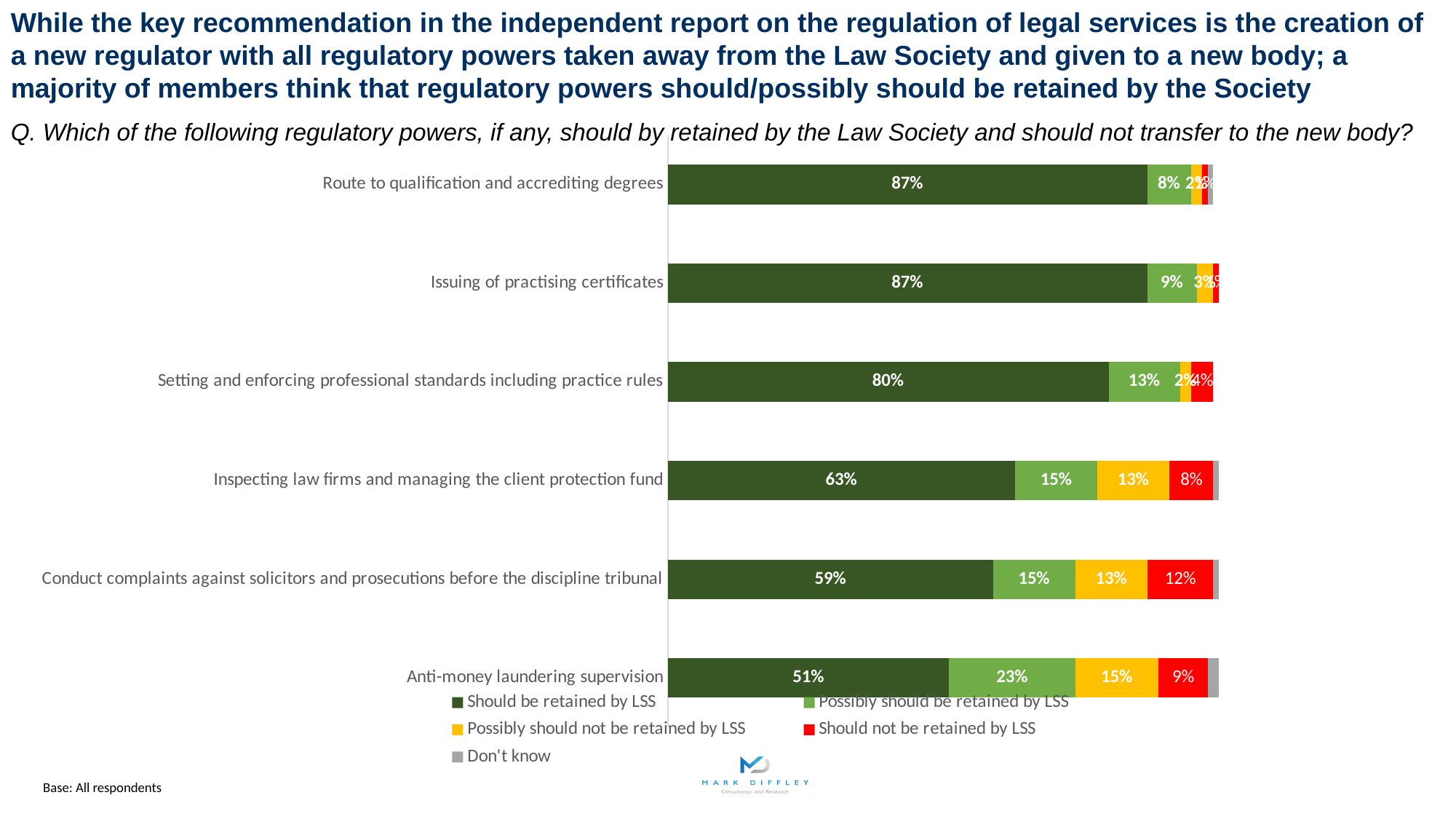
What percentage said anti-money laundering supervision 'Should be retained by LSS'? 51% Which regulatory power has the highest 'Should not be retained by LSS' percentage? Conduct complaints against solicitors and prosecutions before the discipline tribunal How many series does the legend list? 5 What percentage said 'Setting and enforcing professional standards including practice rules' possibly should be retained by LSS? 13% What is the difference in the 'Should be retained by LSS' percentage between 'Setting and enforcing professional standards including practice rules' and 'Inspecting law firms and managing the client protection fund'? 17 percentage points For 'Possibly should not be retained by LSS', which is larger: anti-money laundering supervision or conduct complaints against solicitors? Anti-money laundering supervision What kind of chart is shown on the slide? Stacked bar chart What percentage said 'Inspecting law firms and managing the client protection fund' should not be retained by LSS? 8% Which regulatory power has the lowest 'Should be retained by LSS' percentage? Anti-money laundering supervision How many regulatory powers (categories) are plotted in the chart? 6 What colour represents 'Should not be retained by LSS' in the chart? Red What percentage said anti-money laundering supervision 'Possibly should be retained by LSS'? 23%